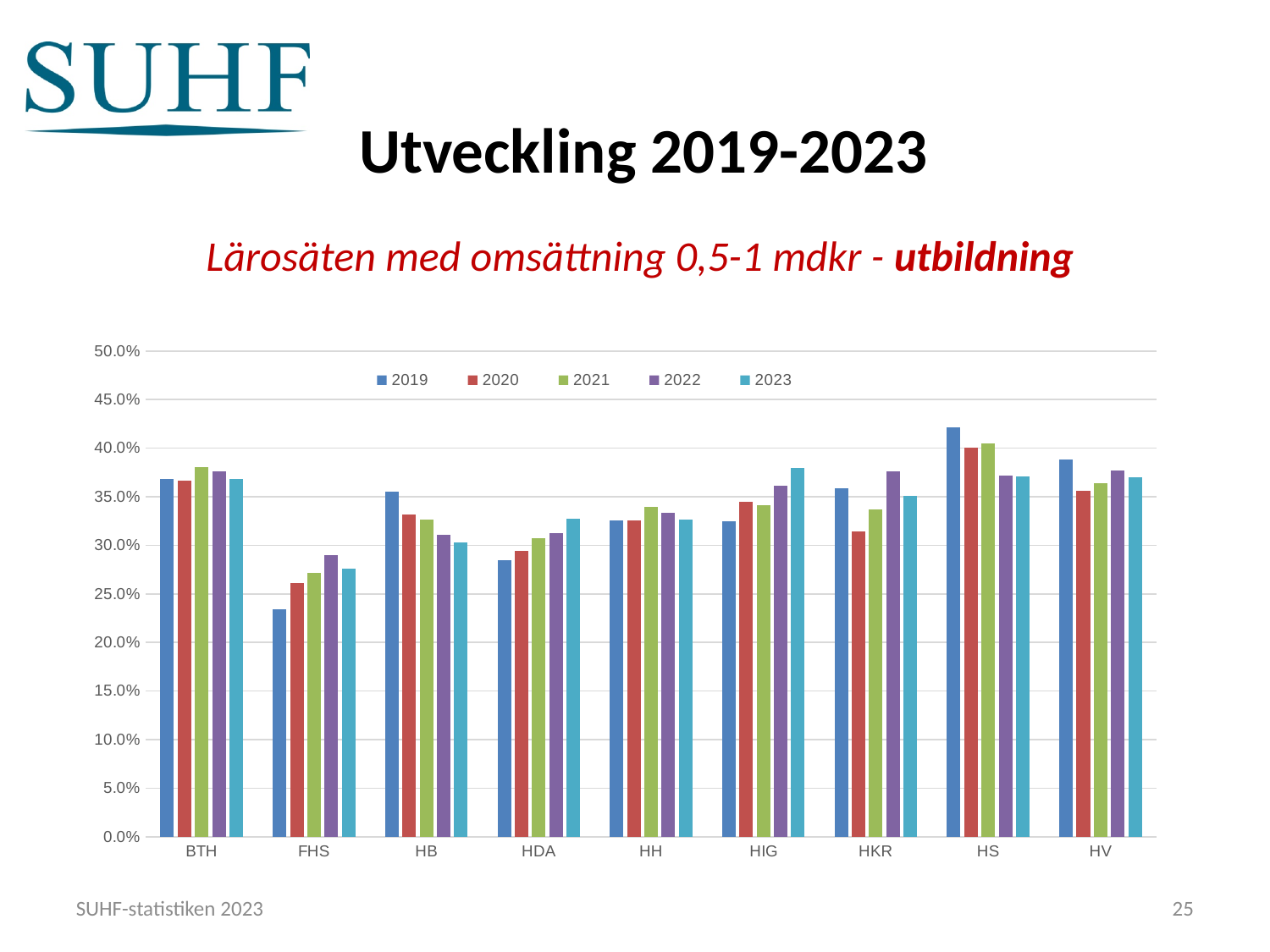
How many series does the legend list? 5 Is the 2019 value for FHS greater or less than 25.0%? less What kind of chart is shown on the slide? bar chart Which category has the highest value for 2019? HS Is the 2020 value for HKR greater or less than 35.0%? less What is the subtitle of the chart shown in red text? Lärosäten med omsättning 0,5-1 mdkr - utbildning Is the 2019 value for HS greater or less than 40.0%? greater Which category has the lowest value for 2023? FHS Which is larger for HKR, the 2020 value or the 2022 value? 2022 Which category has the lowest value for 2019? FHS How many categories (lärosäten) are shown on the x axis? 9 Do the values for HDA rise or fall from 2019 to 2023? rise